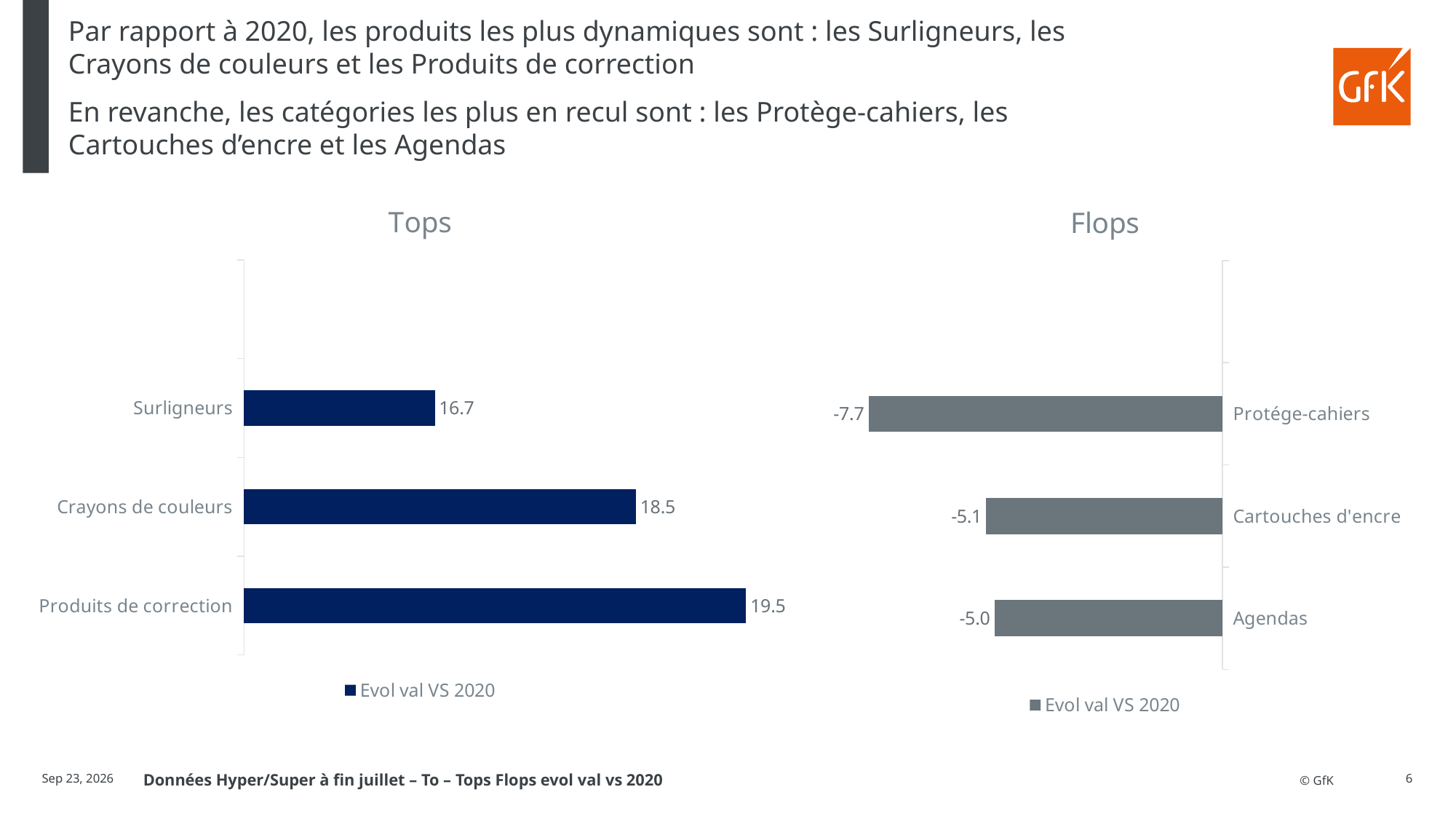
In the 'Tops' chart, what is the value for Crayons de couleurs? 18.5 In the 'Tops' chart, which category has the highest value? Produits de correction In the 'Flops' chart, what is the difference between the values for Cartouches d'encre and Protége-cahiers? 2.6 In the 'Flops' chart, which category has the lowest value? Protége-cahiers In the 'Tops' chart, which is larger: the value for Crayons de couleurs or the value for Surligneurs? Crayons de couleurs How many categories are shown in the 'Flops' chart? 3 In the 'Flops' chart, what is the value for Agendas? -5.0 In the 'Tops' chart, which category has the lowest value? Surligneurs In the 'Flops' chart, what is the value for Protége-cahiers? -7.7 In the 'Tops' chart, what is the difference between the values for Produits de correction and Surligneurs? 2.8 What type of chart is the 'Tops' chart? Bar chart In the 'Tops' chart, what is the value for Surligneurs? 16.7